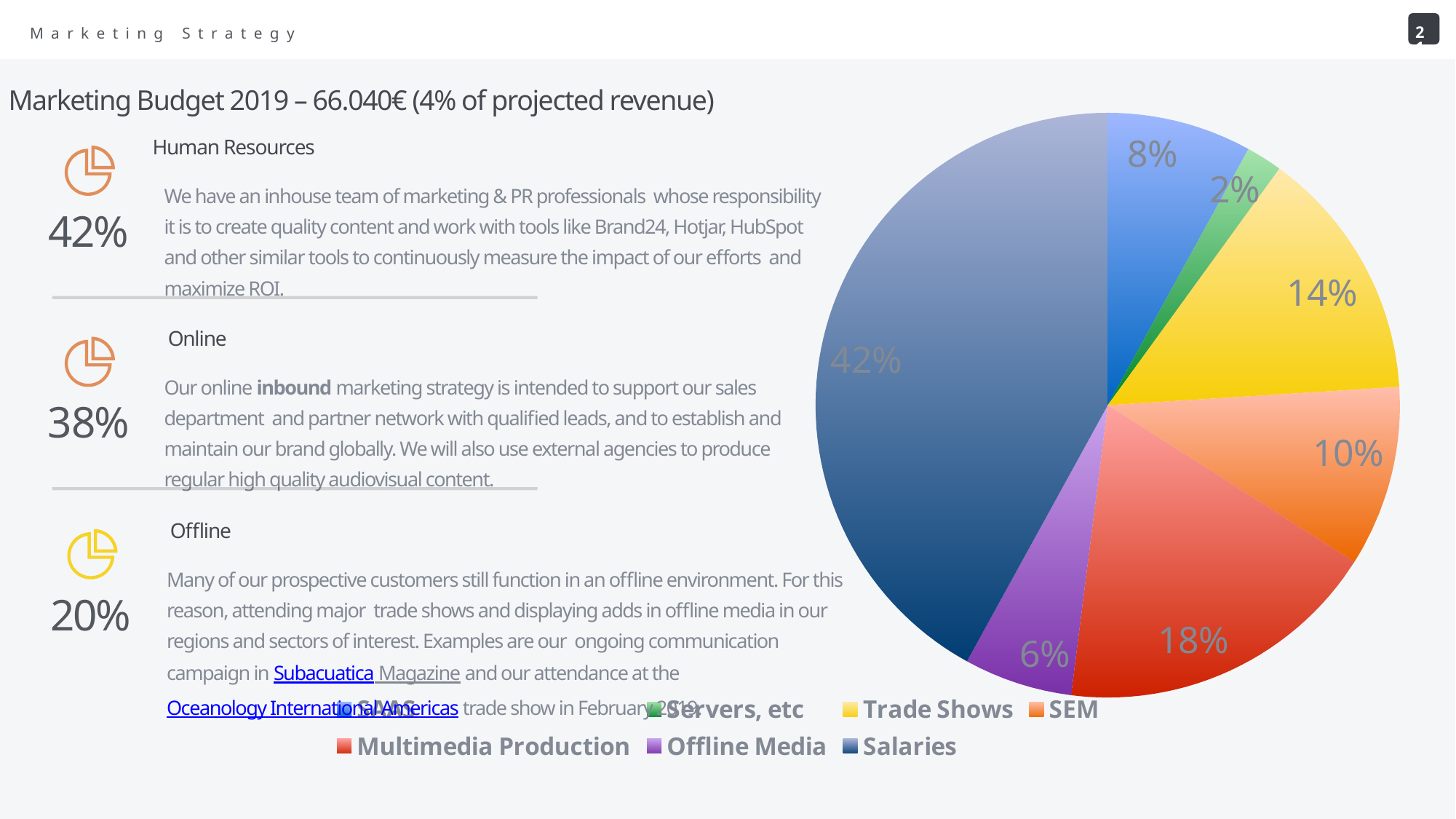
Which category has the largest slice of the pie chart? Salaries What kind of chart is shown on the slide? pie chart What is the difference in percentage points between the Multimedia Production slice and the SEM slice? 8 What share of the pie chart does Multimedia Production take? 18% What share of the pie chart does SEM take? 10% What share of the pie chart does Offline Media take? 6% What share of the pie chart does Salaries take? 42% What share of the pie chart does Trade Shows take? 14% How many categories does the pie chart legend list? 7 What colour is the Offline Media slice in the pie chart? purple Which slice is larger, Trade Shows or SaaS? Trade Shows Which category has the smallest slice of the pie chart? Servers, etc